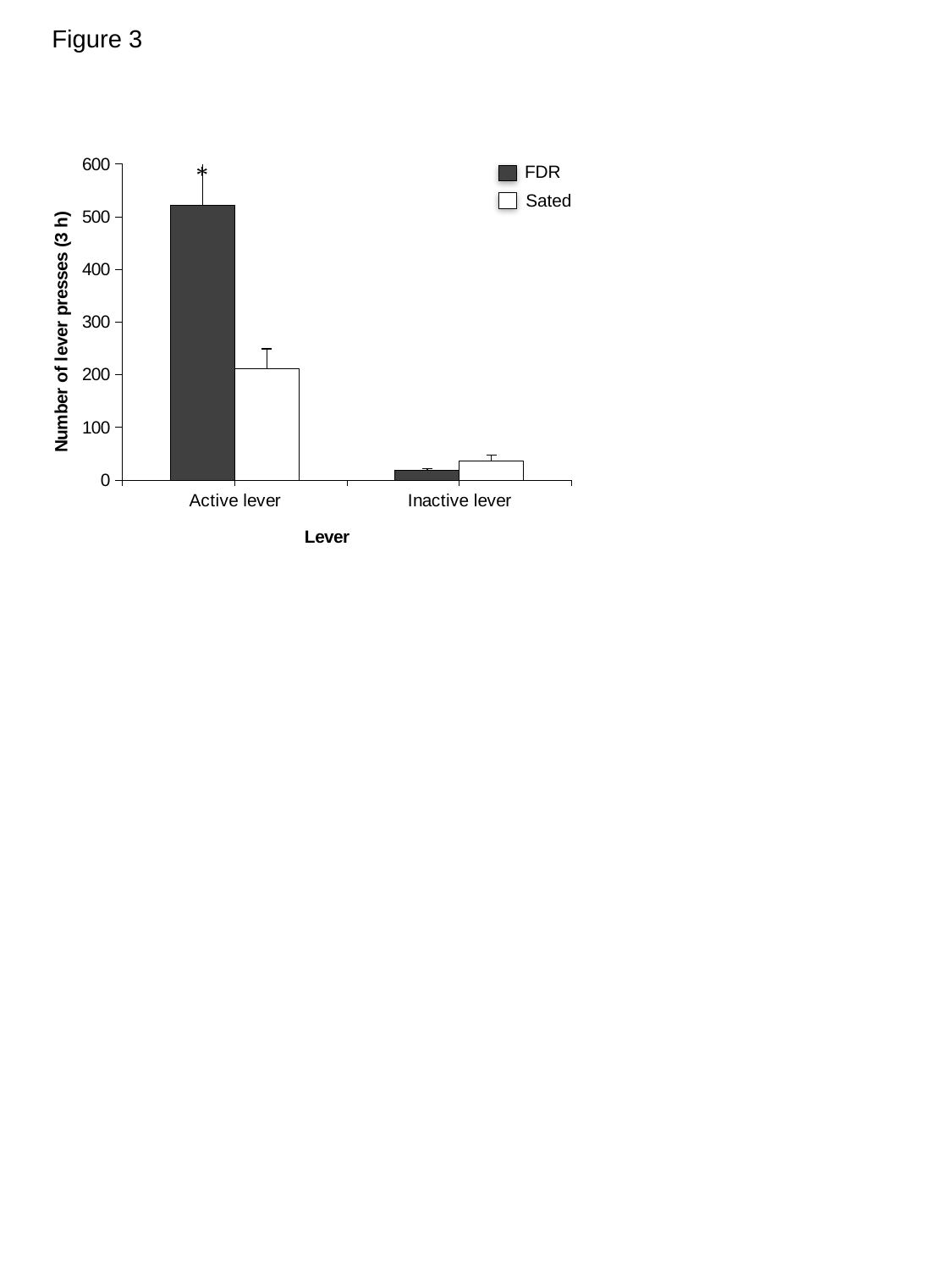
How many lever categories are shown on the x axis? 2 Is the value for Sated on the Active lever greater or less than 300? less What is the label of the y axis? Number of lever presses (3 h) For the Active lever, which series has the larger value, FDR or Sated? FDR Which series has the highest bar in the chart? FDR How many series does the legend list? 2 Is the value for FDR on the Active lever greater or less than 500? greater Is the value for Sated on the Inactive lever greater or less than 100? less Which series is shown with dark filled bars? FDR What kind of chart is shown on the slide? bar chart Which bar is the lowest in the chart? FDR, Inactive lever For the Inactive lever, which series has the larger value, FDR or Sated? Sated